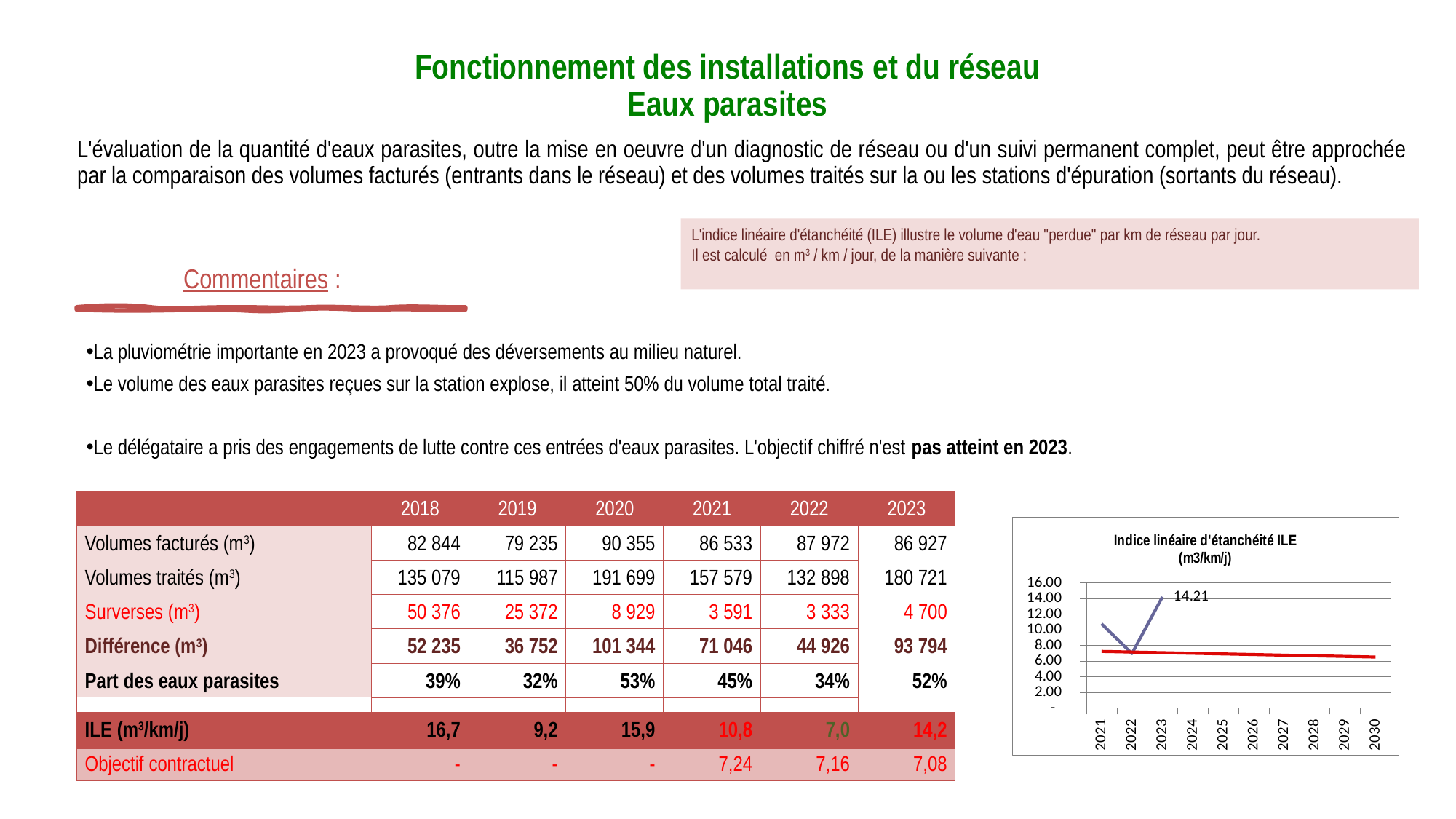
Which is larger on the blue line: the value for 2021 or the value for 2023? 2023 Does the blue line rise or fall from 2022 to 2023? rise In which year does the blue line reach its highest point? 2023 Is the value of the blue line in 2021 greater or less than 8.00? greater How many years are shown along the x axis of the chart? 10 What kind of chart is shown on the slide? Line chart What is the title of the chart? Indice linéaire d'étanchéité ILE (m3/km/j) Does the red line rise or fall from 2021 to 2030? fall Is the value of the red line in 2030 greater or less than 8.00? less What value is labelled on the chart for 2023? 14.21 In which year does the blue line reach its lowest point? 2022 What is the first year shown on the x axis of the chart? 2021